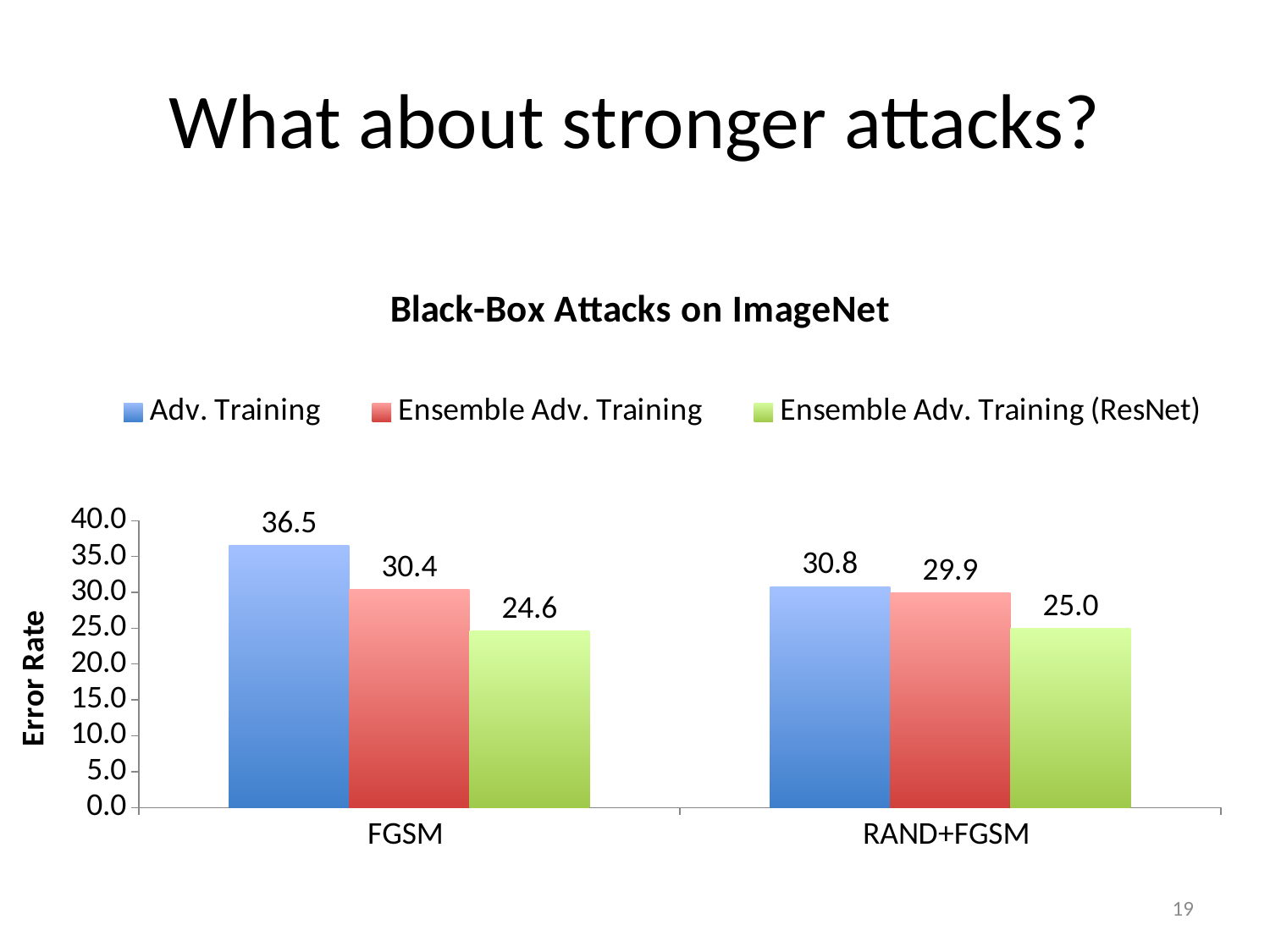
What is the difference between the Adv. Training error rate and the Ensemble Adv. Training error rate under FGSM? 6.1 What is the difference between the Adv. Training error rate under FGSM and under RAND+FGSM? 5.7 How many attack categories are shown on the x axis? 2 What is the error rate for Adv. Training under the FGSM attack? 36.5 Which is larger: the Ensemble Adv. Training (ResNet) error rate under FGSM or under RAND+FGSM? RAND+FGSM Which series has the lowest error rate under the RAND+FGSM attack? Ensemble Adv. Training (ResNet) Which series has the highest error rate under the FGSM attack? Adv. Training How many series does the legend list? 3 What is the error rate for Ensemble Adv. Training under the FGSM attack? 30.4 What is the title of the chart? Black-Box Attacks on ImageNet What is the error rate for Ensemble Adv. Training (ResNet) under the RAND+FGSM attack? 25.0 What kind of chart is shown on the slide? Bar chart